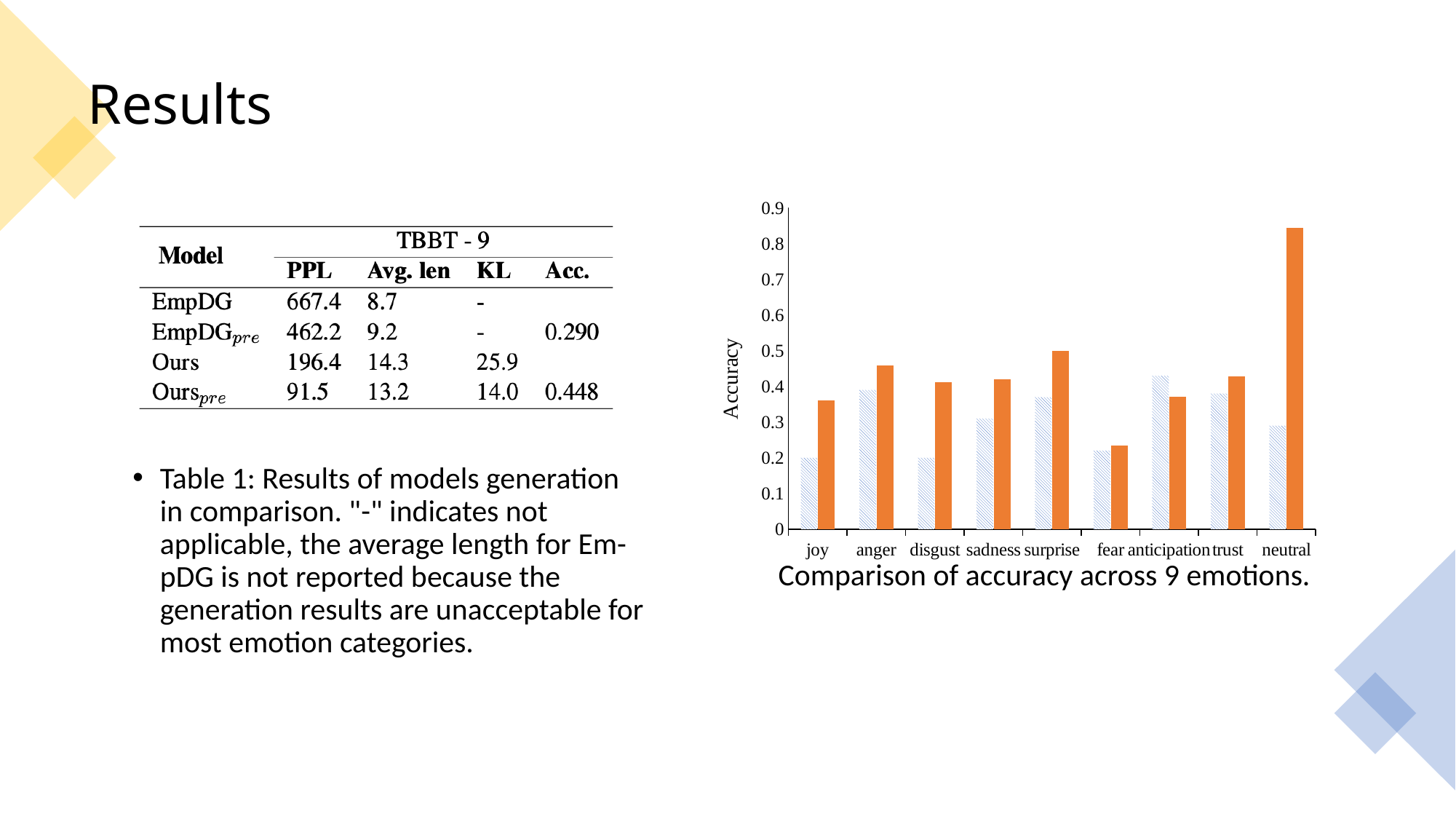
Is the solid orange bar for neutral greater or less than 0.8? greater How many emotion categories are shown on the x axis of the chart? 9 Is the solid orange bar for surprise greater or less than 0.4? greater Which has the taller solid orange bar, anger or joy? anger Is the solid orange bar for joy greater or less than 0.4? less Which emotion has the lowest solid orange bar in the chart? fear For anticipation, which bar is taller, the hatched blue bar or the solid orange bar? the hatched blue bar Which emotion has the highest solid orange bar in the chart? neutral What is the label on the y axis of the chart? Accuracy What is the caption written below the chart? Comparison of accuracy across 9 emotions. What kind of chart is shown on the slide? bar chart